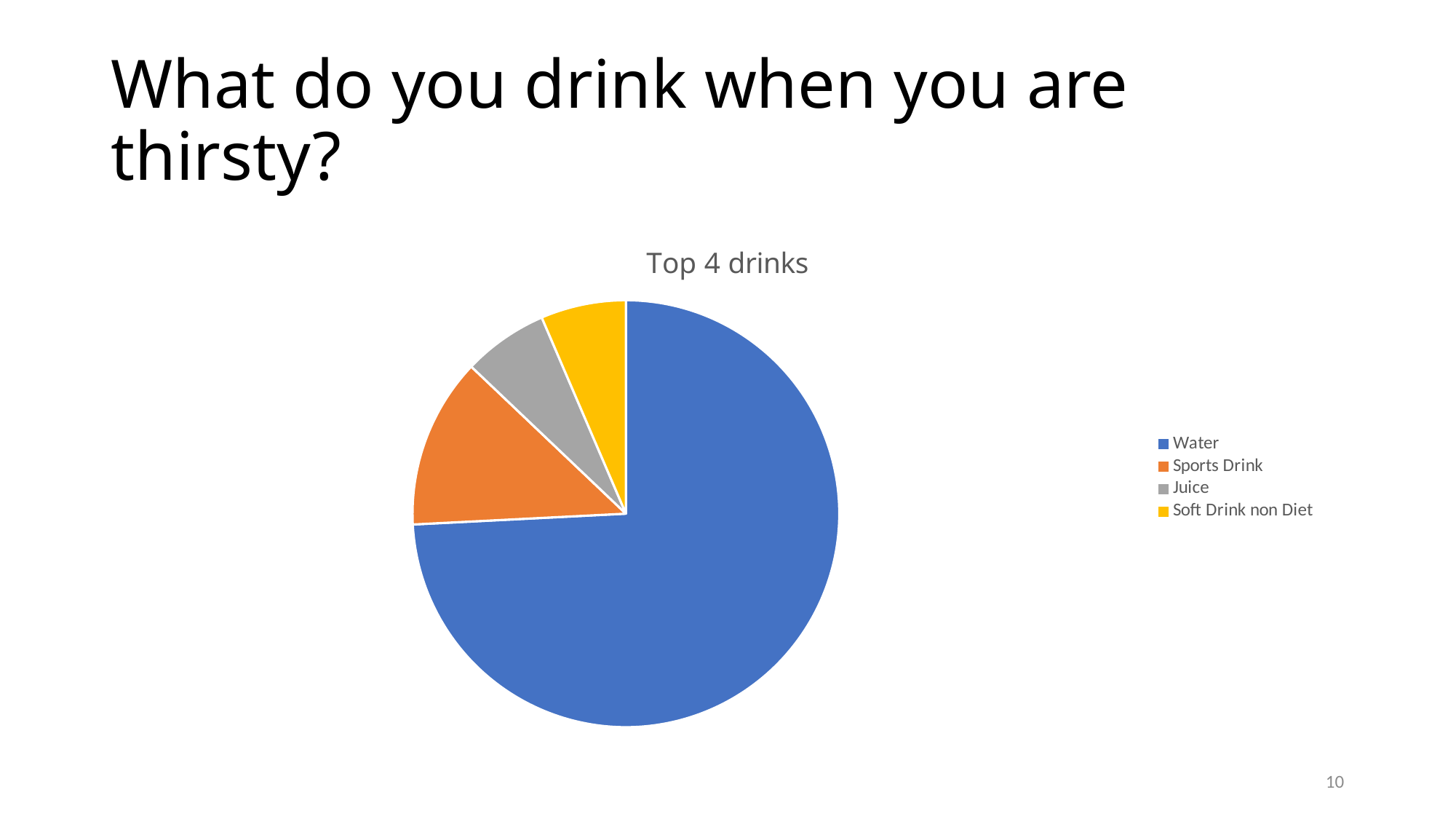
Which slice is larger, Sports Drink or Juice? Sports Drink How many entries does the legend list? 4 Which drink is shown in yellow in the pie chart? Soft Drink non Diet Which colour represents Juice in the pie chart? grey Which drink has the largest slice of the pie? Water How many slices does the pie chart have? 4 Which slice is larger, Sports Drink or Soft Drink non Diet? Sports Drink What kind of chart is shown on the slide? pie chart What is the title of the chart? Top 4 drinks Which slice is larger, Water or Sports Drink? Water